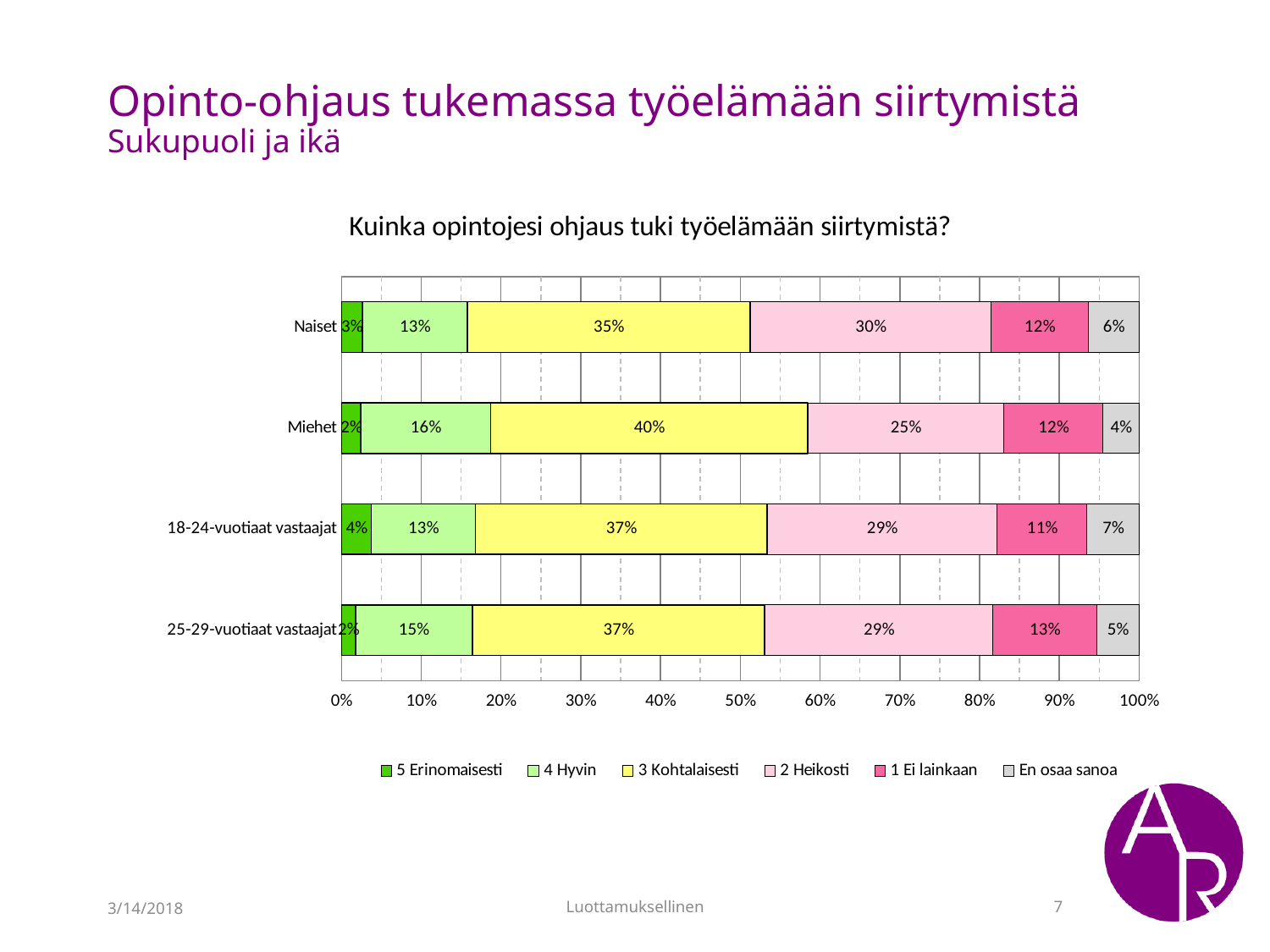
What kind of chart is shown on the slide? Stacked bar chart How many series does the legend list? 6 What is the value of '3 Kohtalaisesti' for Miehet? 40% What is the value of 'En osaa sanoa' for 18-24-vuotiaat vastaajat? 7% What is the value of '4 Hyvin' for 25-29-vuotiaat vastaajat? 15% Which category has the lowest value for '1 Ei lainkaan'? 18-24-vuotiaat vastaajat What is the title of the chart? Kuinka opintojesi ohjaus tuki työelämään siirtymistä? Which category has the highest value for '3 Kohtalaisesti'? Miehet What is the value of '2 Heikosti' for Naiset? 30% How many categories are plotted on the chart? 4 What is the difference between the '4 Hyvin' values for Miehet and Naiset? 3% Which is larger: the '2 Heikosti' value for Naiset or for Miehet? Naiset